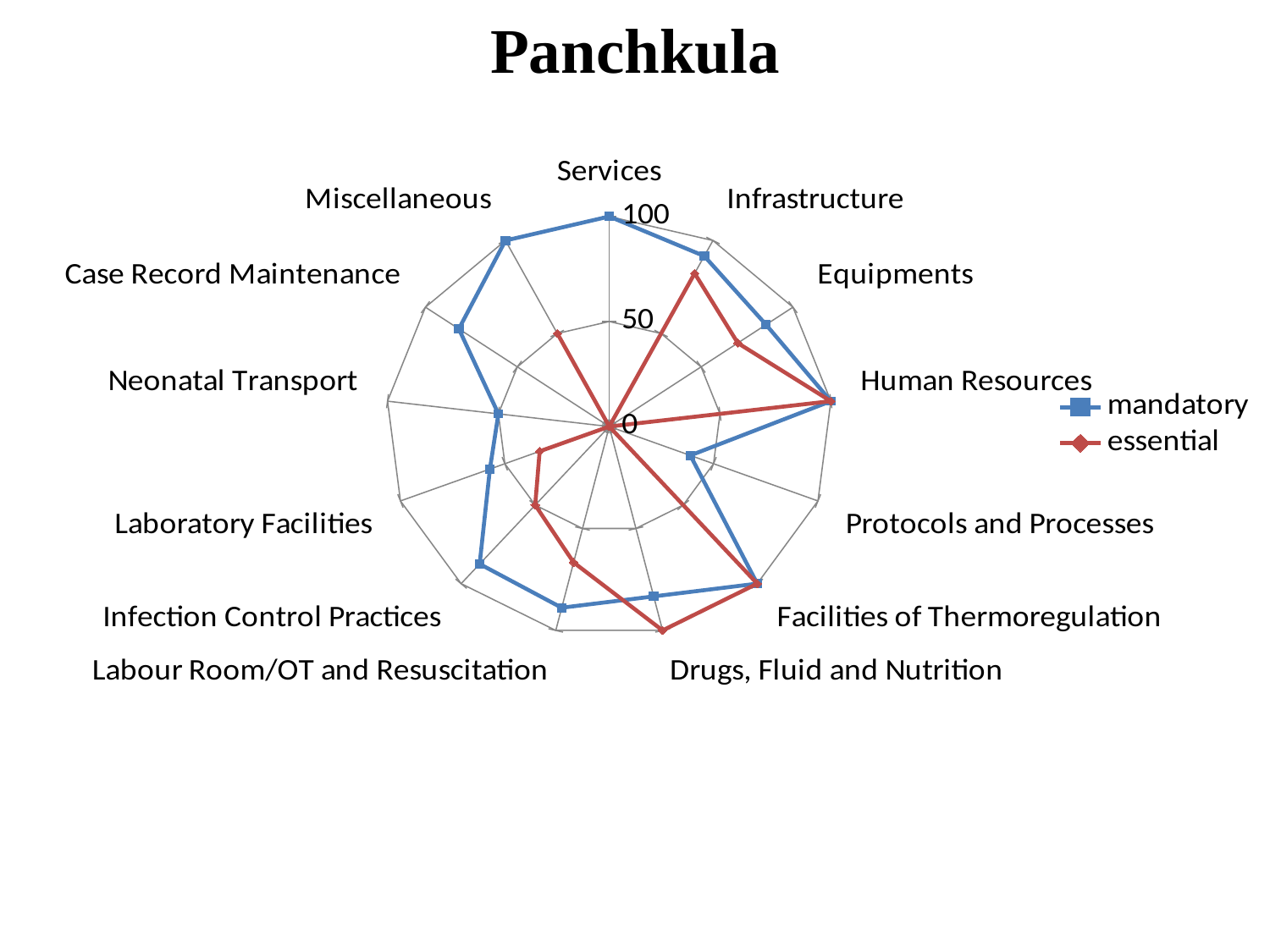
Is the mandatory value for Protocols and Processes greater or less than 50? less For Drugs, Fluid and Nutrition, which series has the larger value, mandatory or essential? essential What is the mandatory value for Services? 100 What is the essential value for Services? 0 How many series does the legend list? 2 For Equipments, which series has the larger value, mandatory or essential? mandatory How many categories are plotted around the radar chart? 13 What is the essential value for Human Resources? 100 What kind of chart is shown on the slide? radar chart Is the mandatory value for Case Record Maintenance greater or less than 50? greater What are the two series named in the legend? mandatory and essential Is the mandatory value for Infrastructure greater or less than 50? greater